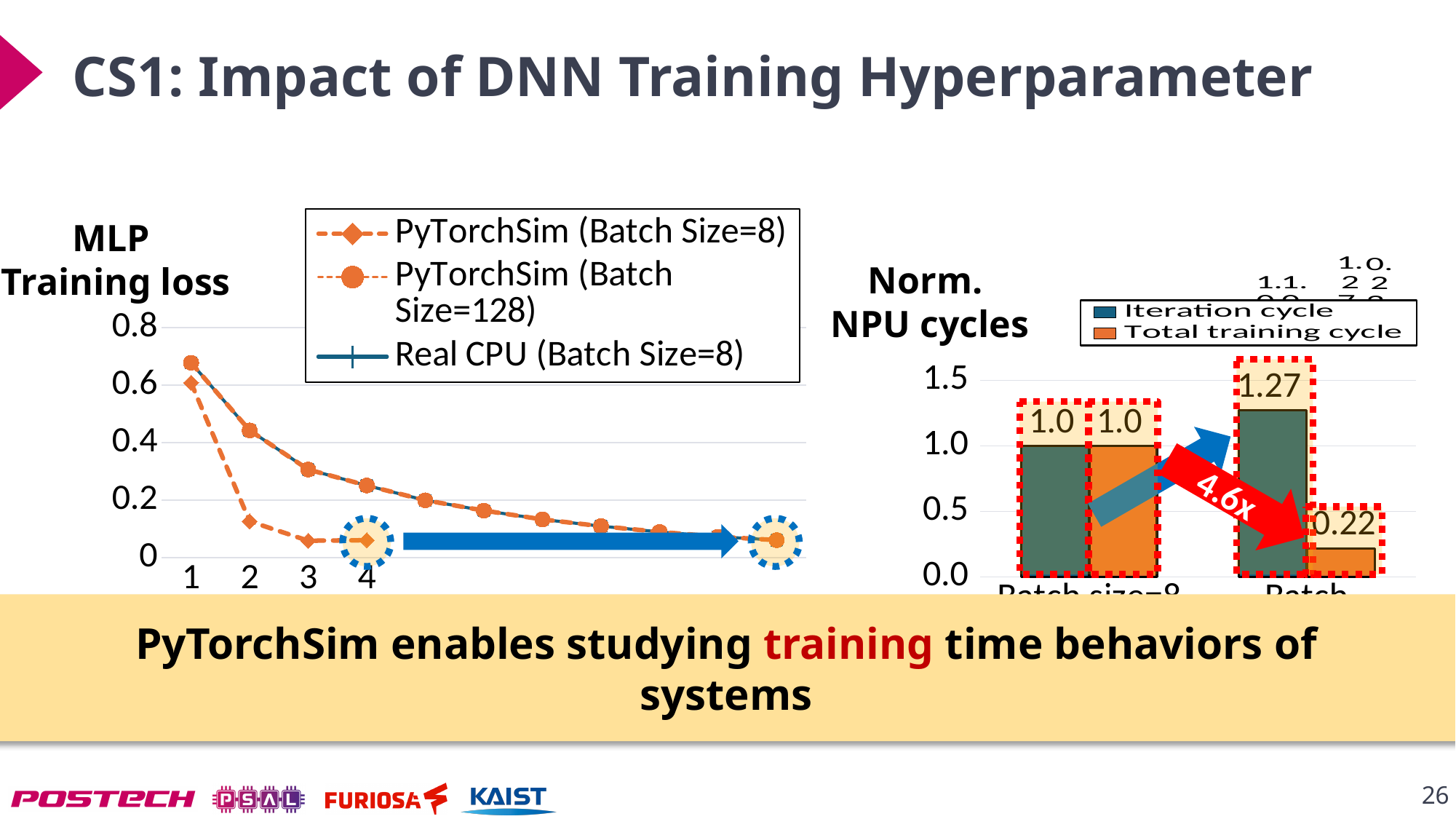
In the Norm. NPU cycles chart, is the Total training cycle larger for Batch size=8 or for the second (right-hand) batch size group? Batch size=8 In the Norm. NPU cycles chart, what is the difference between the Iteration cycle and Total training cycle values in the second (right-hand) batch size group? 1.05 In the Norm. NPU cycles chart, what is the Total training cycle value for the second (right-hand) batch size group? 0.22 How many series does the legend of the Norm. NPU cycles chart list? 2 What kind of chart is the MLP Training loss chart on the left? line chart In the MLP Training loss chart, is the PyTorchSim (Batch Size=8) value at x=2 greater or less than 0.2? less How many series does the legend of the MLP Training loss chart list? 3 In the Norm. NPU cycles chart, which bar is the highest? Iteration cycle in the second (right-hand) batch size group (1.27) In the MLP Training loss chart, does the PyTorchSim (Batch Size=128) series rise or fall along the x axis? fall In the Norm. NPU cycles chart, what is the Iteration cycle value for the second (right-hand) batch size group? 1.27 In the Norm. NPU cycles chart, what is the Iteration cycle value for Batch size=8? 1.0 What kind of chart is the Norm. NPU cycles chart on the right? bar chart